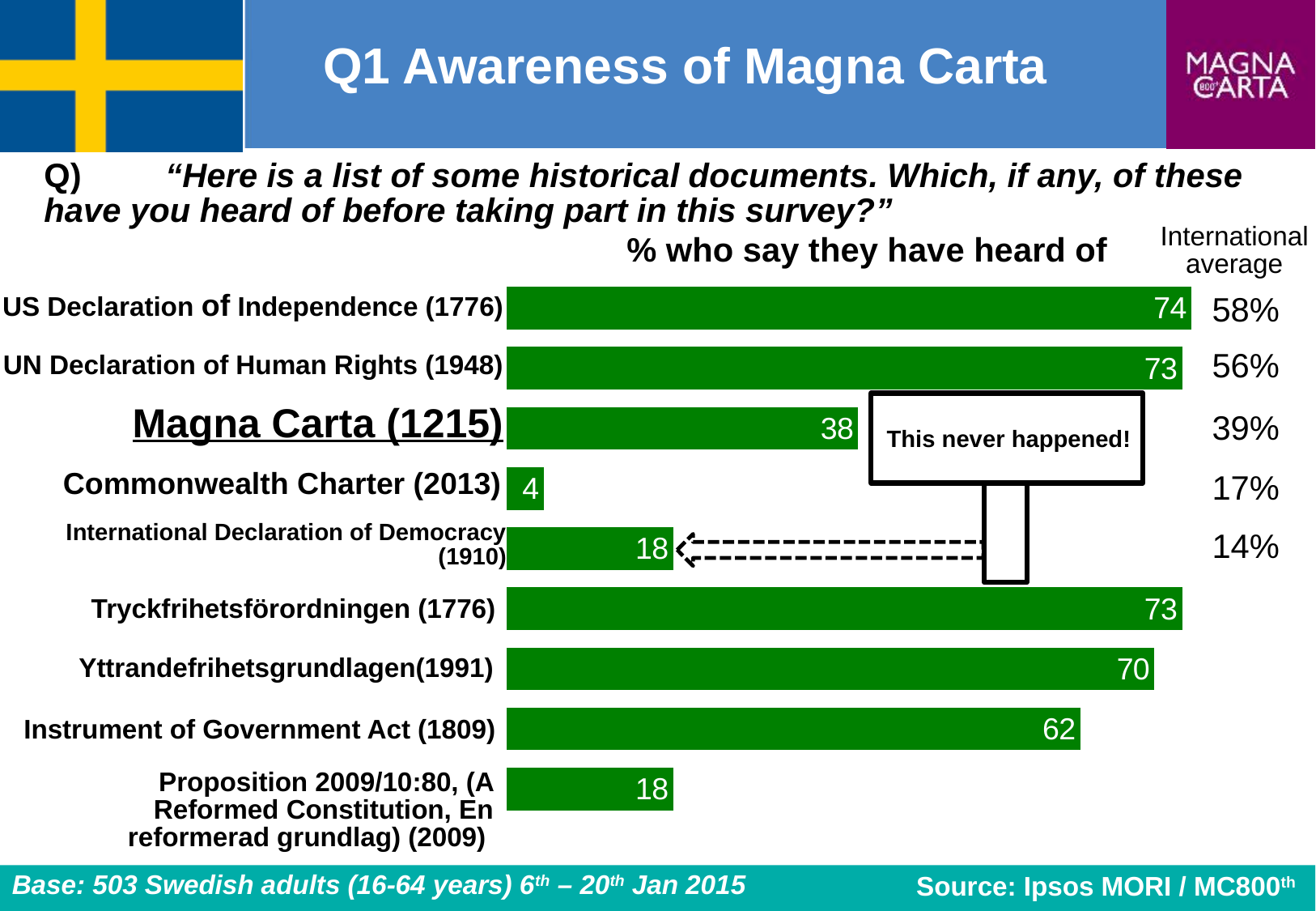
What percentage say they have heard of Magna Carta (1215)? 38 Which document has the lowest percentage of people who say they have heard of it? Commonwealth Charter (2013) What is the value shown for the Instrument of Government Act (1809)? 62 What percentage of Swedish adults say they have heard of the US Declaration of Independence (1776)? 74 What is the value shown for the Commonwealth Charter (2013)? 4 What is the difference between the values for the US Declaration of Independence (1776) and Magna Carta (1215)? 36 Which document has the highest percentage of people who say they have heard of it? US Declaration of Independence (1776) What is the difference between the value for the UN Declaration of Human Rights (1948) and the International Declaration of Democracy (1910)? 55 How many documents are listed in the chart? 9 What kind of chart is shown on the slide? Bar chart What is the international average shown for Magna Carta (1215)? 39% Which has a higher value: Yttrandefrihetsgrundlagen (1991) or the Instrument of Government Act (1809)? Yttrandefrihetsgrundlagen (1991)